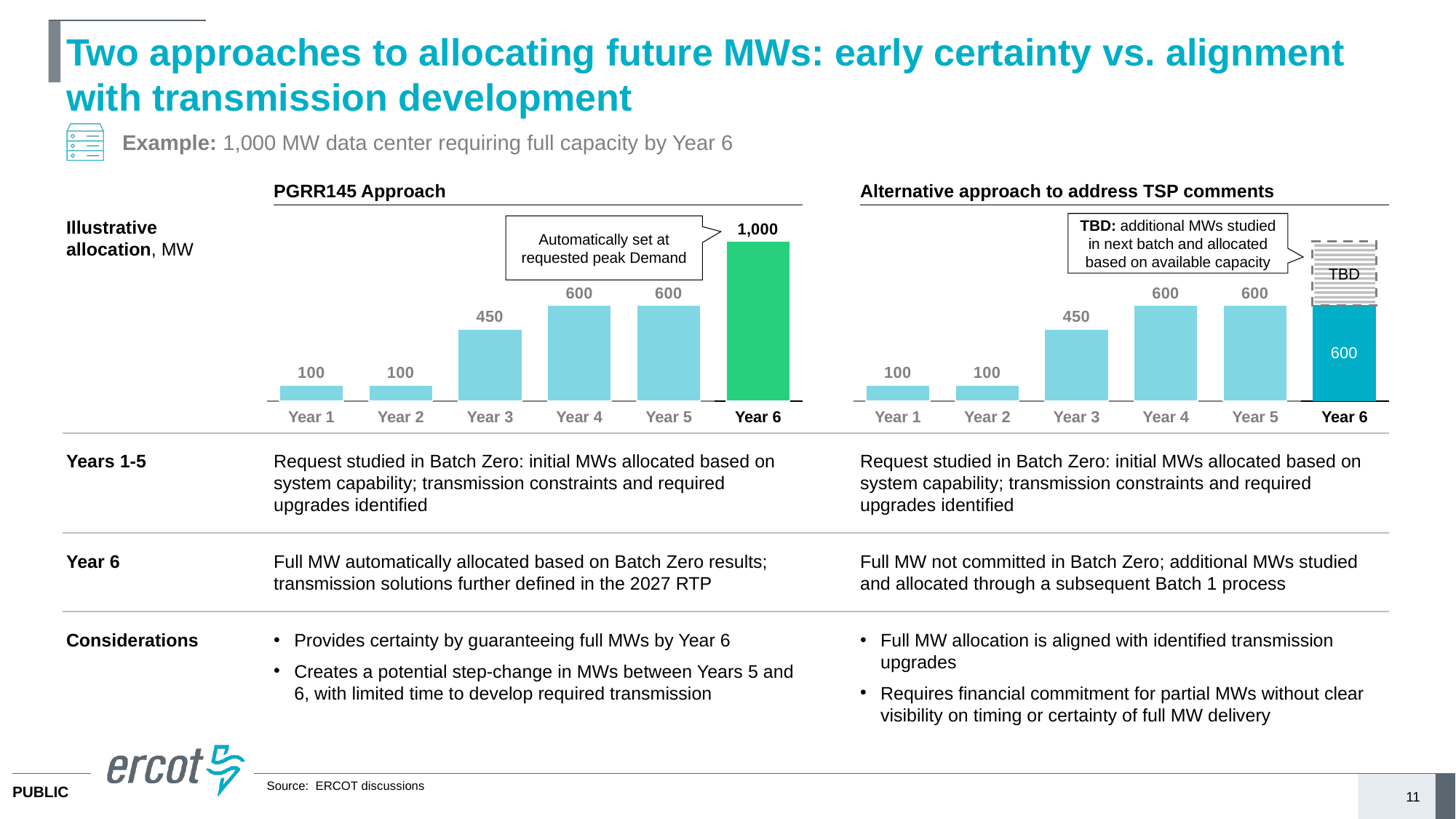
In the Alternative approach chart, what label appears on the hatched portion above the Year 6 bar? TBD In the PGRR145 Approach chart, do the values rise or fall from Year 1 to Year 6? Rise In the PGRR145 Approach chart, what is the illustrative allocation for Year 6? 1,000 In the PGRR145 Approach chart, which year has the highest allocation? Year 6 In the Alternative approach chart, what is the labelled value of the solid portion of the Year 6 bar? 600 How many years are shown on the x axis of the PGRR145 Approach chart? 6 In the Alternative approach chart, what is the difference between the Year 3 and Year 2 values? 350 In the PGRR145 Approach chart, what is the difference between the Year 6 and Year 5 values? 400 In the PGRR145 Approach chart, what is the value for Year 3? 450 What is the title of the chart on the left side of the slide? PGRR145 Approach In the PGRR145 Approach chart, is the value for Year 4 larger than the value for Year 3? Yes What kind of chart is used for the Alternative approach to address TSP comments? Bar chart